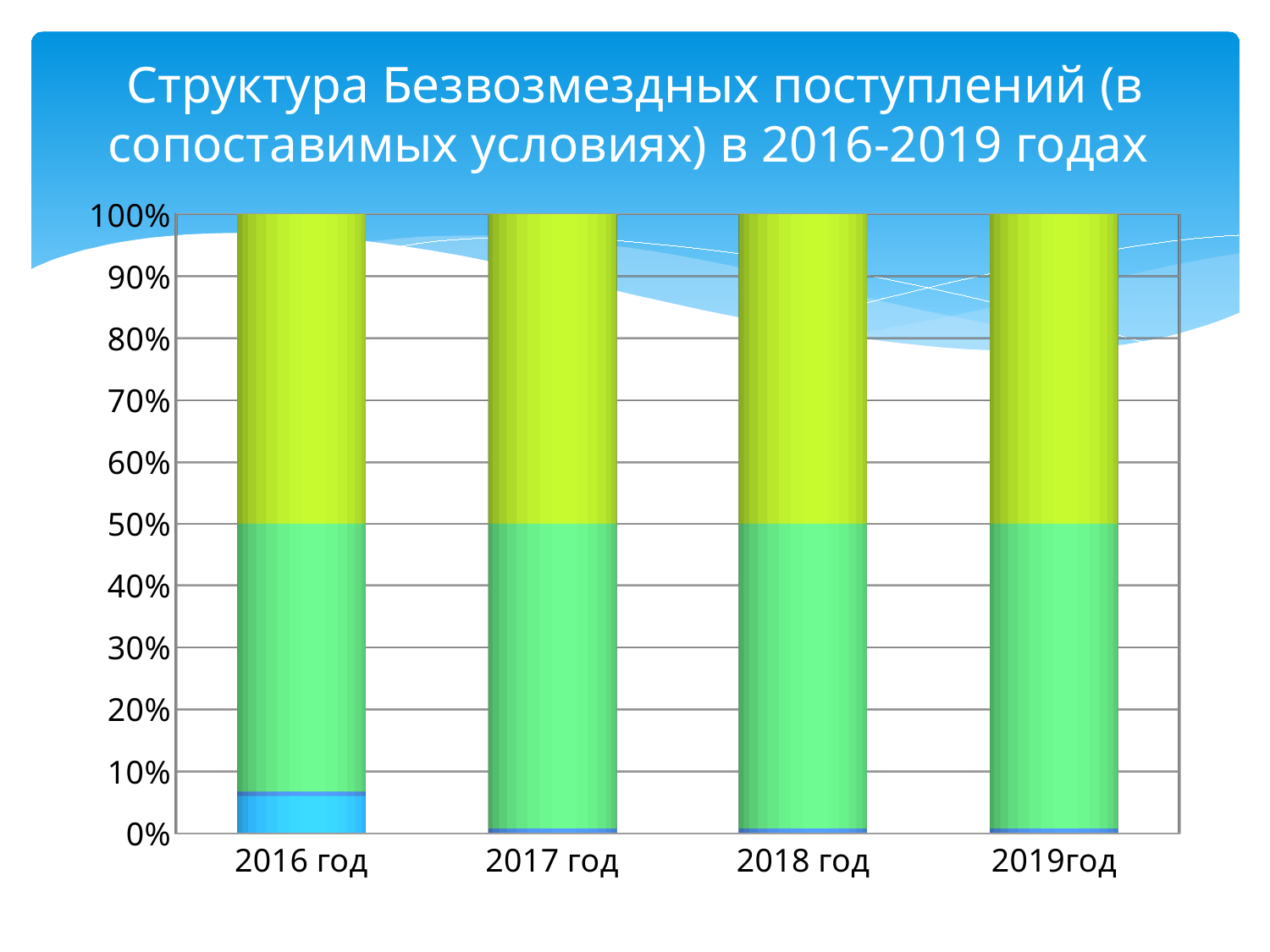
Is the boundary between the green and yellow-green segments in the 2019год bar greater or less than 70%? less Is the blue (bottom) segment larger in 2016 год or in 2018 год? 2016 год Is the blue (bottom) segment of the 2016 год bar greater or less than 10%? less What is the highest tick value shown on the vertical axis? 100% What value does the top of each stacked bar reach on the vertical axis? 100% Is the blue (bottom) segment of the 2017 год bar greater or less than 10%? less Which year has the largest blue (bottom) segment? 2016 год What is the title of the chart on the slide? Структура Безвозмездных поступлений (в сопоставимых условиях) в 2016-2019 годах What kind of chart is shown on the slide? stacked bar chart Does the blue (bottom) segment rise or fall from 2016 год to 2017 год? fall What is the label of the first category on the x axis? 2016 год How many years (categories) are shown on the x axis of the chart? 4